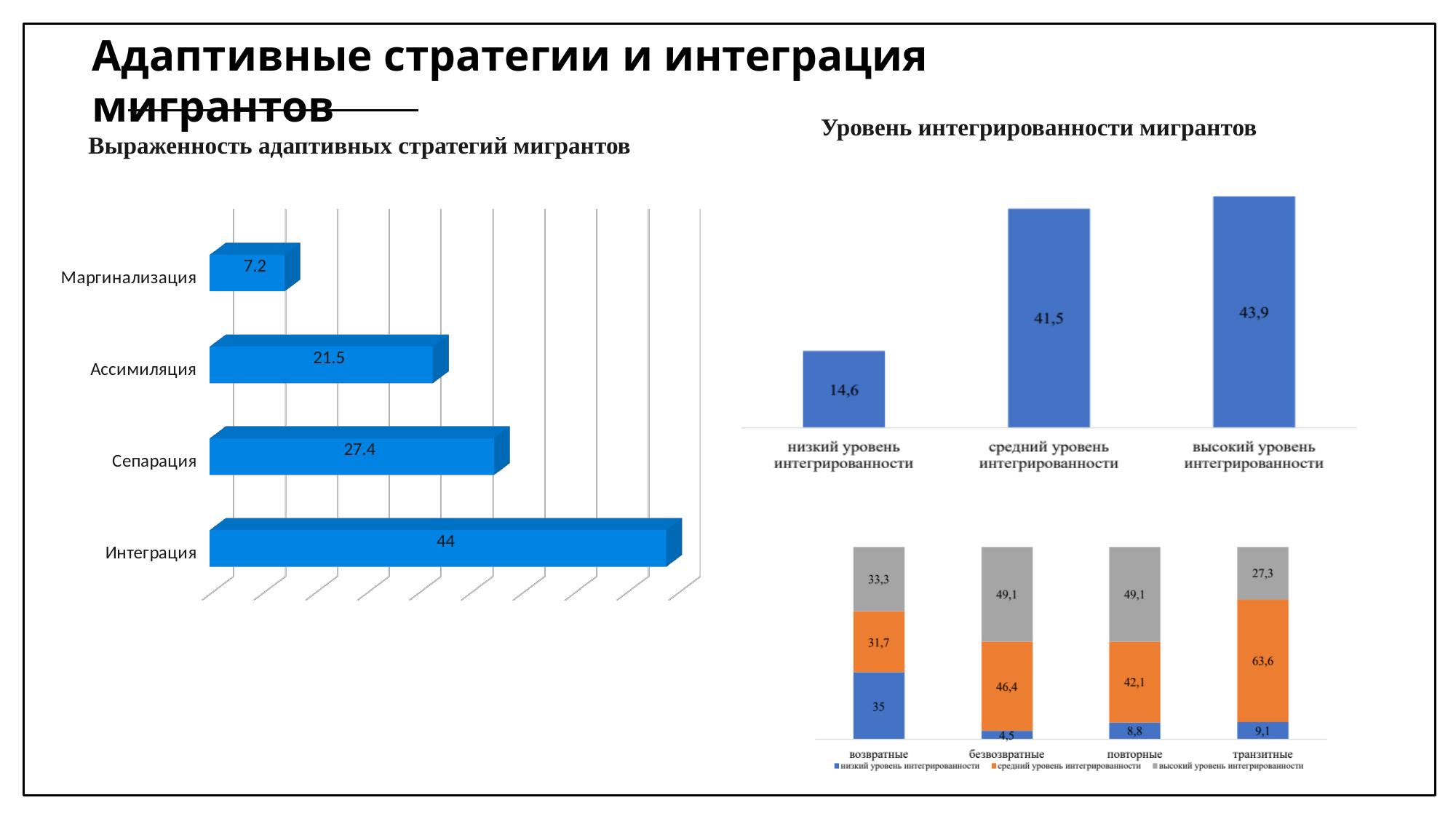
What kind of chart is 'Выраженность адаптивных стратегий мигрантов'? Bar chart In the chart 'Выраженность адаптивных стратегий мигрантов', what is the value for Интеграция? 44 In the chart 'Уровень интегрированности мигрантов', what is the difference between высокий and низкий уровень интегрированности? 29,3 In the stacked bar chart at the bottom right, is the value of высокий уровень интегрированности larger for возвратные or for повторные? повторные In the chart 'Выраженность адаптивных стратегий мигрантов', what is the difference between Сепарация and Ассимиляция? 5.9 In the stacked bar chart at the bottom right, how many series does the legend list? 3 In the chart 'Выраженность адаптивных стратегий мигрантов', which category has the lowest value? Маргинализация In the stacked bar chart at the bottom right, which category has the lowest value for низкий уровень интегрированности? безвозвратные In the chart 'Выраженность адаптивных стратегий мигрантов', how many categories are shown? 4 In the chart 'Уровень интегрированности мигрантов', which category has the highest value? высокий уровень интегрированности In the stacked bar chart at the bottom right, what is the value of средний уровень интегрированности for транзитные? 63,6 In the chart 'Уровень интегрированности мигрантов', what is the value for средний уровень интегрированности? 41,5